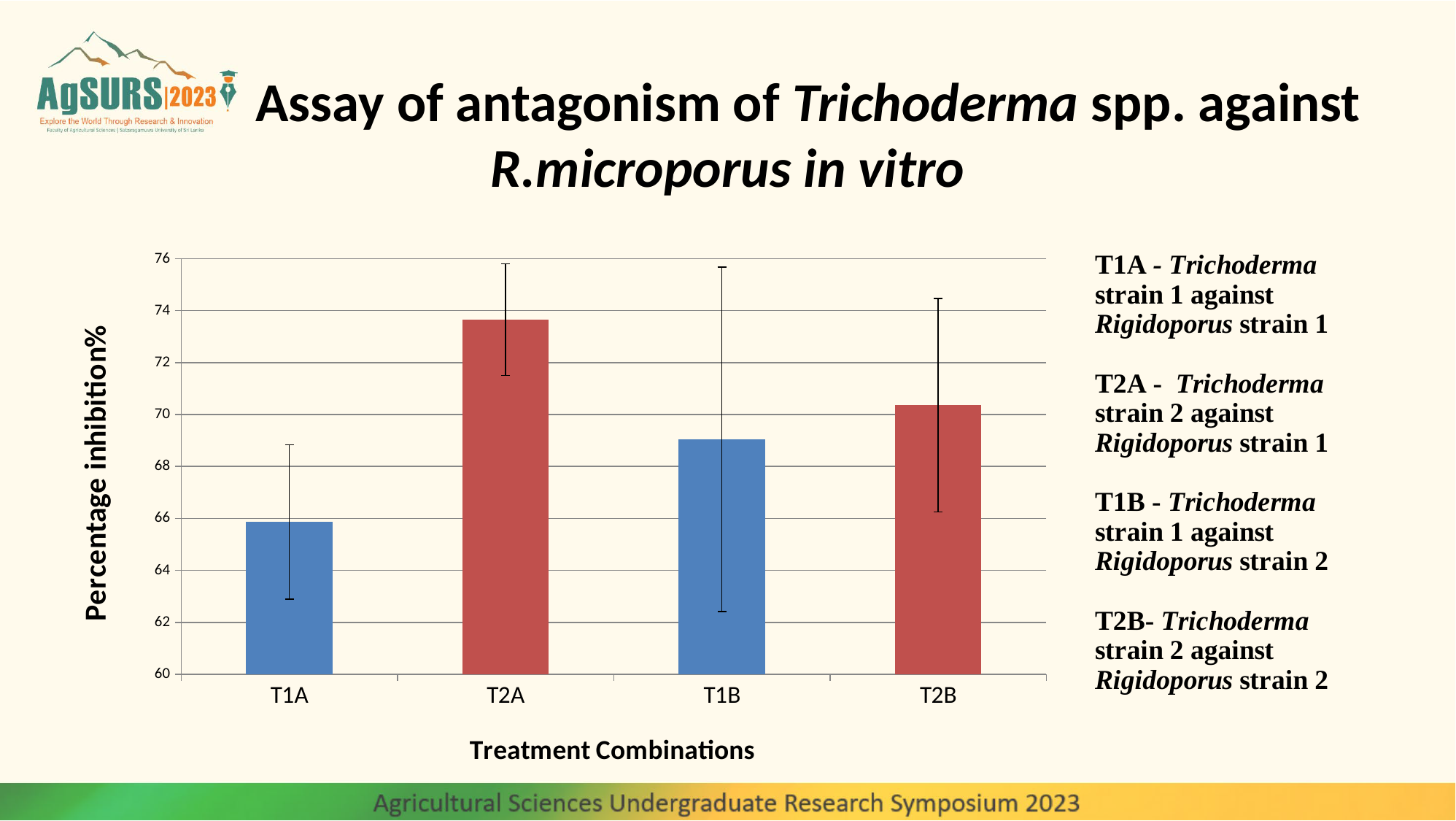
Which has the higher percentage inhibition, T1B or T1A? T1B Is the value for T1A greater or less than 64? greater Is the value for T1B greater or less than 70? less Which has the higher percentage inhibition, T2A or T1B? T2A Is the value for T2B greater or less than 72? less What is the title of the y axis? Percentage inhibition% Which has the higher percentage inhibition, T2A or T1A? T2A How many treatment combinations are plotted on the x axis? 4 Which treatment combination has the highest percentage inhibition? T2A What kind of chart is shown on the slide? bar chart Which treatment combination has the lowest percentage inhibition? T1A